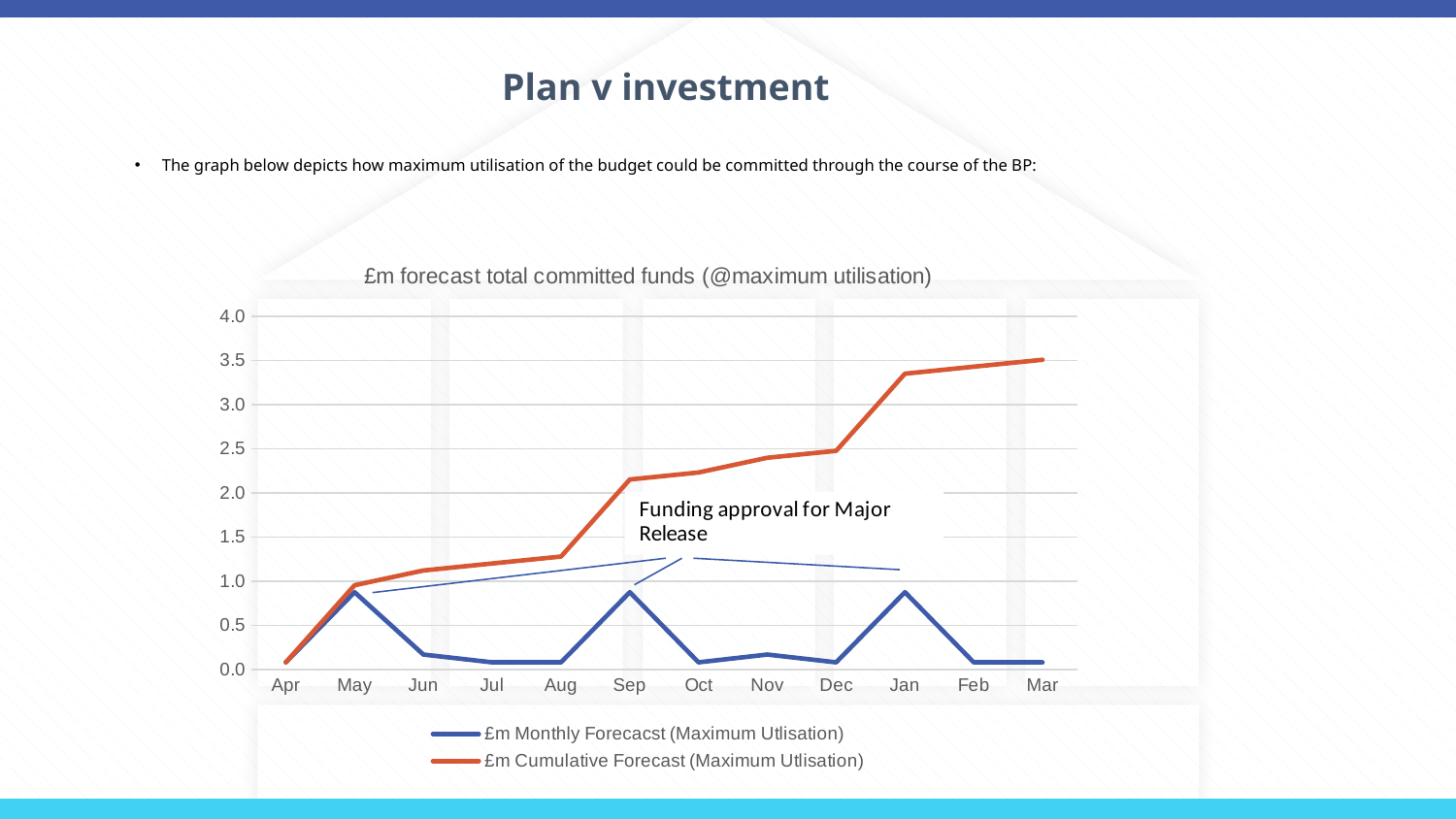
What kind of chart is shown on the slide? line chart In which month is the £m Cumulative Forecast (Maximum Utlisation) value highest? Mar Which series is drawn in orange? £m Cumulative Forecast (Maximum Utlisation) Is the £m Cumulative Forecast (Maximum Utlisation) value for Mar greater or less than 3.0? greater Does the £m Cumulative Forecast (Maximum Utlisation) series rise or fall from Apr to Mar? rise What is the title of the chart? £m forecast total committed funds (@maximum utilisation) Is the £m Cumulative Forecast (Maximum Utlisation) value for Apr greater or less than 0.5? less Is the £m Monthly Forecacst (Maximum Utlisation) value for Sep greater or less than 0.5? greater How many months are shown on the x axis of the chart? 12 How many series does the chart's legend list? 2 In which month is the £m Cumulative Forecast (Maximum Utlisation) value lowest? Apr Which is larger for the £m Cumulative Forecast (Maximum Utlisation) series: the value for Jan or the value for Jun? Jan